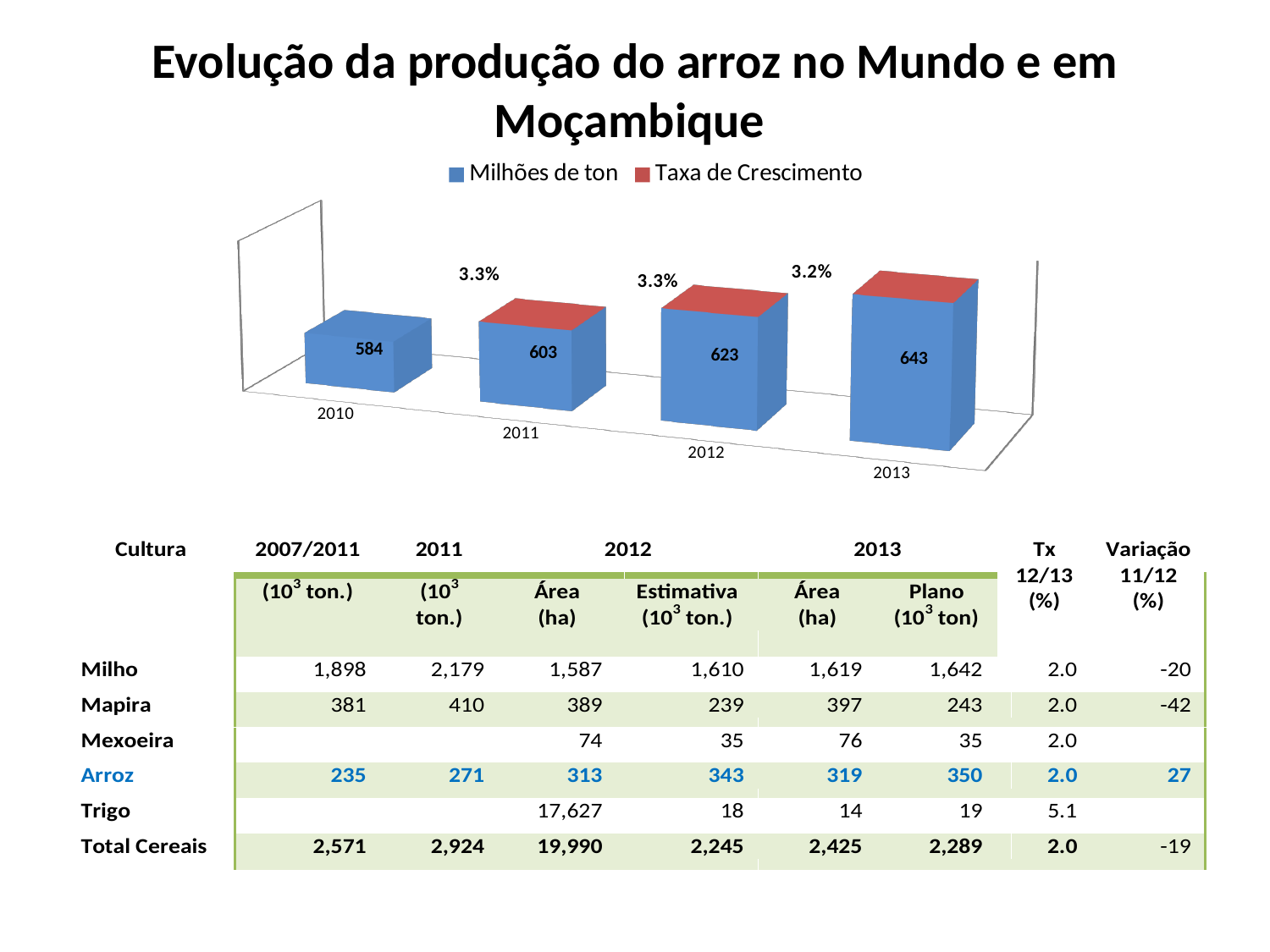
How many years are shown on the x axis of the chart? 4 Which year has the lowest value of Milhões de ton? 2010 Which year has the highest value of Milhões de ton? 2013 What is the value of Milhões de ton for 2012? 623 What is the difference in Milhões de ton between 2013 and 2010? 59 What is the difference in Milhões de ton between 2012 and 2011? 20 Do the Milhões de ton values rise or fall from 2010 to 2013? rise How many series does the chart legend list? 2 What is the value of Milhões de ton for 2010? 584 What is the Taxa de Crescimento shown for 2013? 3.2% What is the Taxa de Crescimento shown for 2011? 3.3% Which is larger, the Milhões de ton value for 2011 or for 2012? 2012